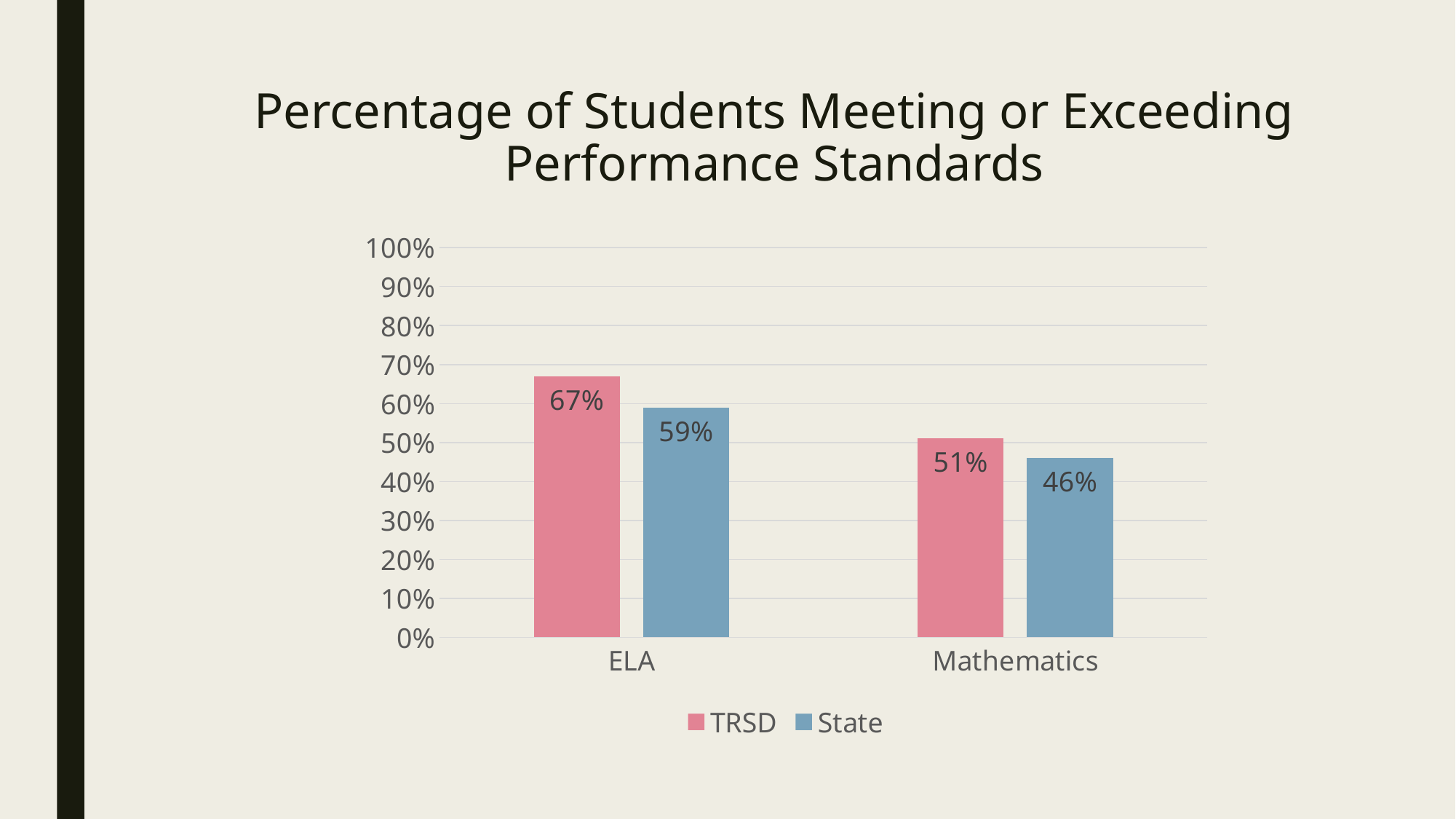
Which category has the lowest State value? Mathematics Which is larger for Mathematics, the TRSD value or the State value? TRSD What is the State value for Mathematics? 46% Which category has the highest TRSD value? ELA What is the difference between the TRSD and State values for Mathematics? 5% How many categories are shown on the x axis? 2 How many series does the legend list? 2 What is the TRSD value for Mathematics? 51% What is the State value for ELA? 59% What is the difference between the TRSD and State values for ELA? 8% What kind of chart is shown on the slide? Bar chart What is the TRSD value for ELA? 67%